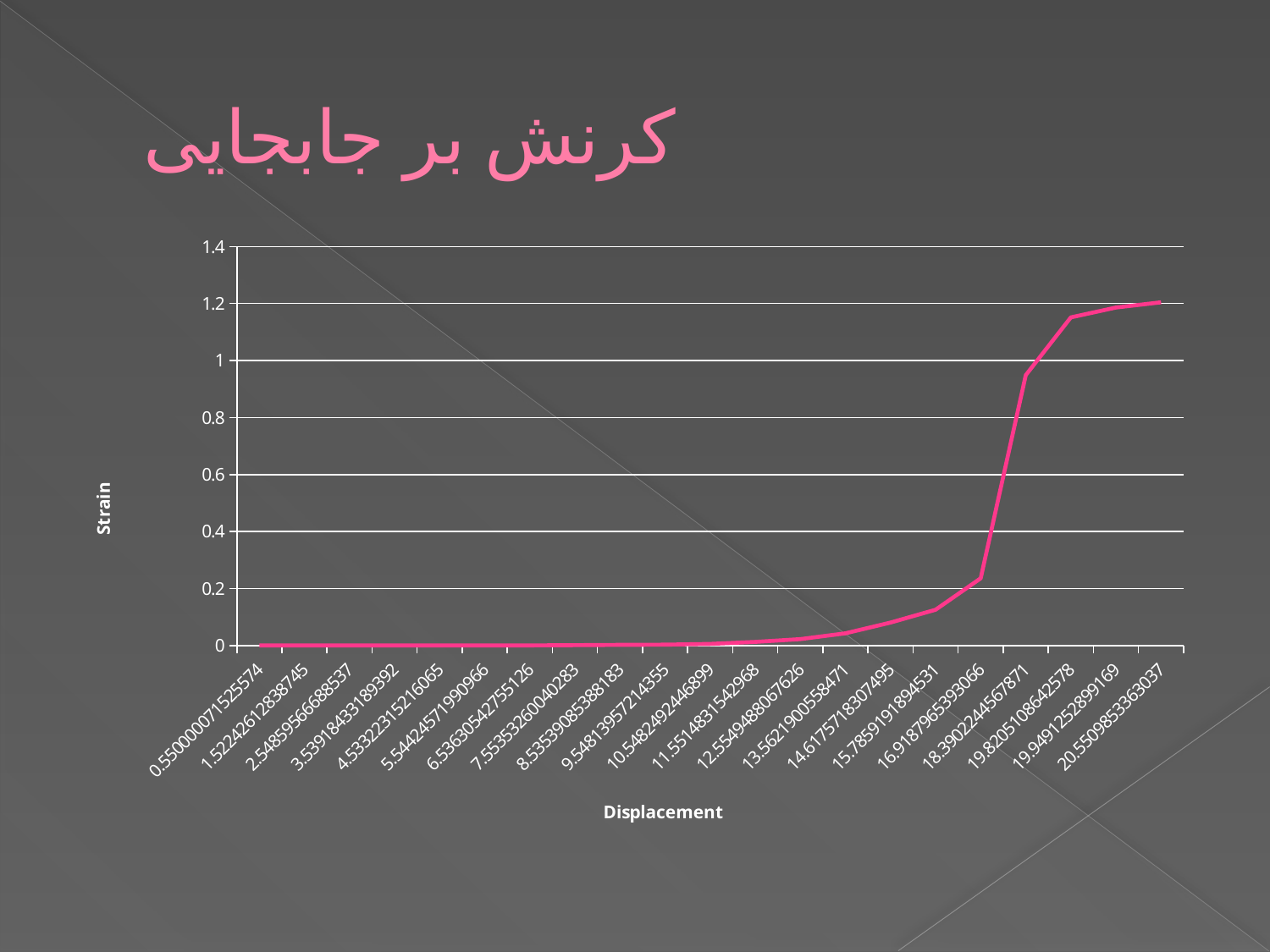
What is the title of the horizontal axis? Displacement What is the title of the vertical axis? Strain Is the strain value at displacement 18.3902244567871 greater or less than 0.4? greater What kind of chart is shown on the slide? line chart Is the strain value at displacement 10.5482492446899 greater or less than 0.2? less Is the strain value at displacement 20.5509853363037 greater or less than 1? greater How many data points are plotted along the x axis? 21 Which has the larger strain value: displacement 20.5509853363037 or displacement 16.9187965393066? 20.5509853363037 Do the strain values generally rise or fall as displacement increases along the x axis? rise At which displacement value is the strain highest? 20.5509853363037